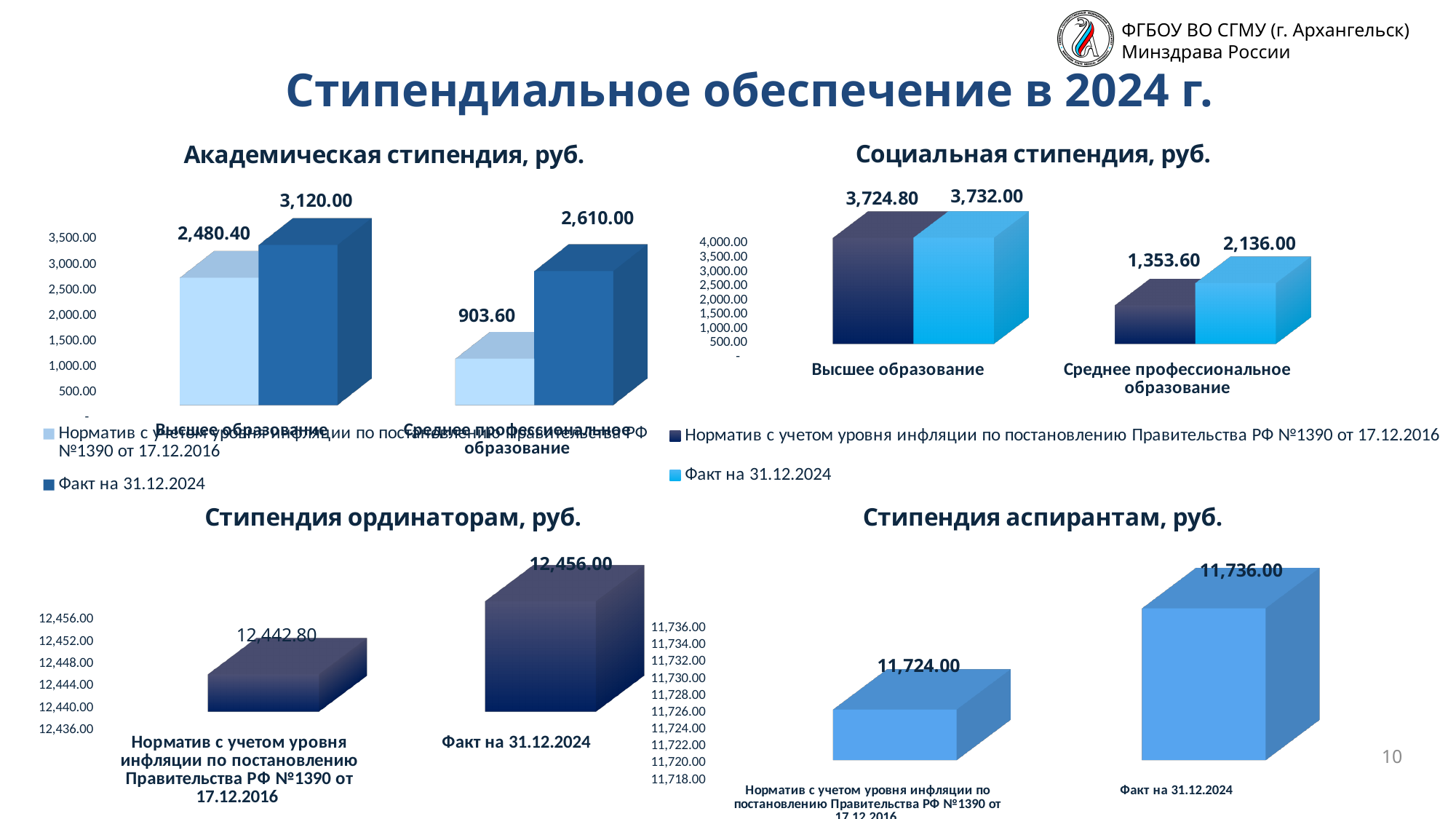
How many series does the legend of the chart titled "Академическая стипендия, руб." list? 2 In the chart titled "Стипендия аспирантам, руб.", what is the норматив value? 11,724.00 In the chart titled "Социальная стипендия, руб.", which category has the lowest норматив value? Среднее профессиональное образование In the chart titled "Социальная стипендия, руб.", what is the value of "Факт на 31.12.2024" for "Среднее профессиональное образование"? 2,136.00 In the chart titled "Академическая стипендия, руб.", what is the value of "Норматив с учетом уровня инфляции по постановлению Правительства РФ №1390 от 17.12.2016" for "Среднее профессиональное образование"? 903.60 What kind of chart is the chart titled "Стипендия аспирантам, руб."? Bar chart In the chart titled "Стипендия ординаторам, руб.", what is the difference between "Факт на 31.12.2024" and the норматив value? 13.20 In the chart titled "Социальная стипендия, руб.", what is the норматив value for "Высшее образование"? 3,724.80 In the chart titled "Стипендия аспирантам, руб.", which bar is higher: "Факт на 31.12.2024" or the норматив bar? Факт на 31.12.2024 In the chart titled "Стипендия ординаторам, руб.", what is the value of "Факт на 31.12.2024"? 12,456.00 In the chart titled "Академическая стипендия, руб.", what is the value of "Факт на 31.12.2024" for "Высшее образование"? 3,120.00 In the chart titled "Академическая стипендия, руб.", what is the difference between "Факт на 31.12.2024" and the норматив value for "Высшее образование"? 639.60